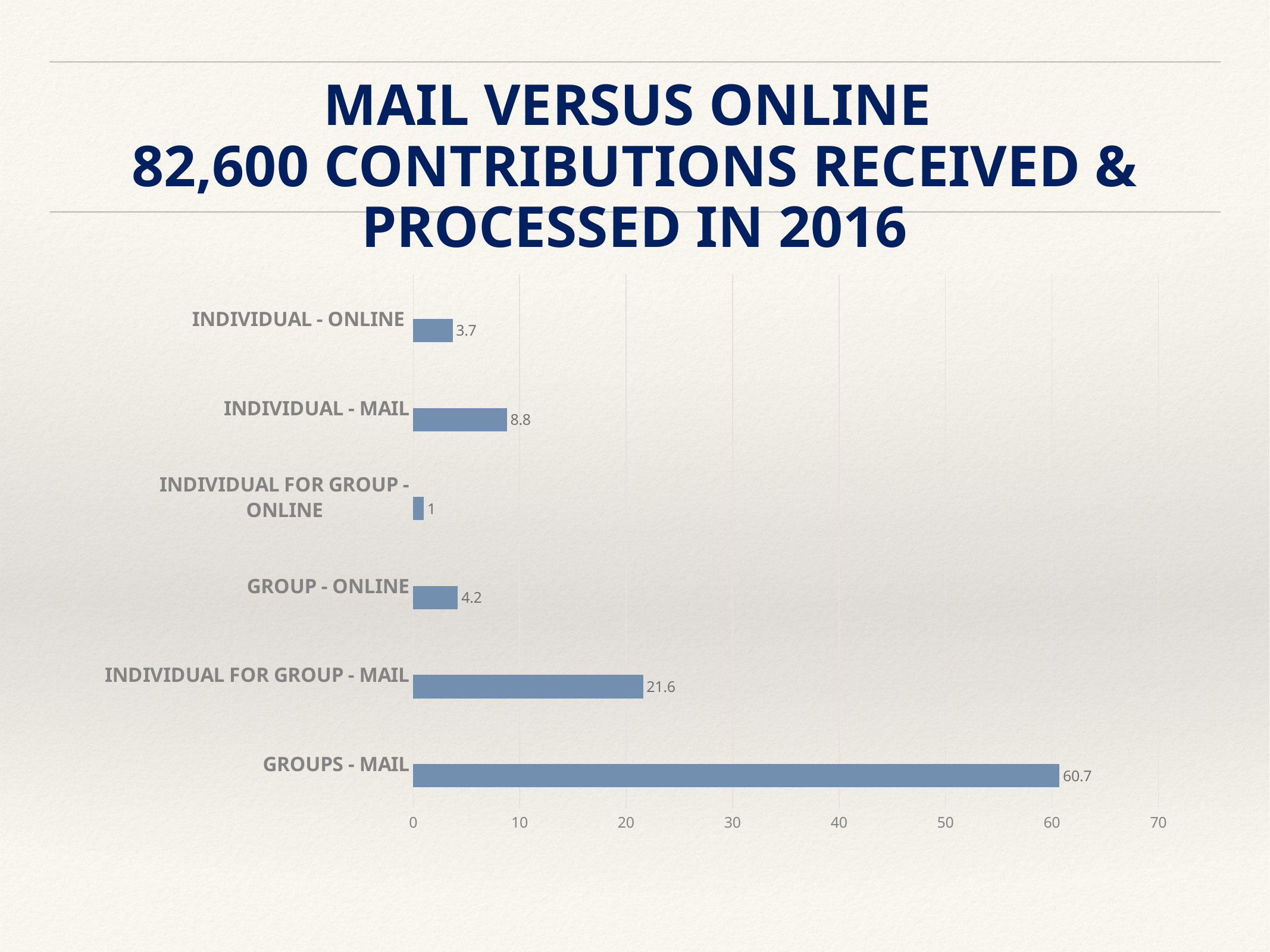
Is the value for INDIVIDUAL FOR GROUP - MAIL greater or less than 20? greater What is the value for INDIVIDUAL FOR GROUP - MAIL? 21.6 Which category has the highest value? GROUPS - MAIL Which is larger, the value for INDIVIDUAL - MAIL or the value for GROUP - ONLINE? INDIVIDUAL - MAIL What is the value for INDIVIDUAL - ONLINE? 3.7 What is the value for GROUPS - MAIL? 60.7 What kind of chart is shown on the slide? bar chart What is the value for GROUP - ONLINE? 4.2 What is the difference between the values for INDIVIDUAL - MAIL and INDIVIDUAL - ONLINE? 5.1 Which category has the lowest value? INDIVIDUAL FOR GROUP - ONLINE What is the difference between the values for GROUPS - MAIL and INDIVIDUAL FOR GROUP - MAIL? 39.1 How many categories are shown in the chart? 6